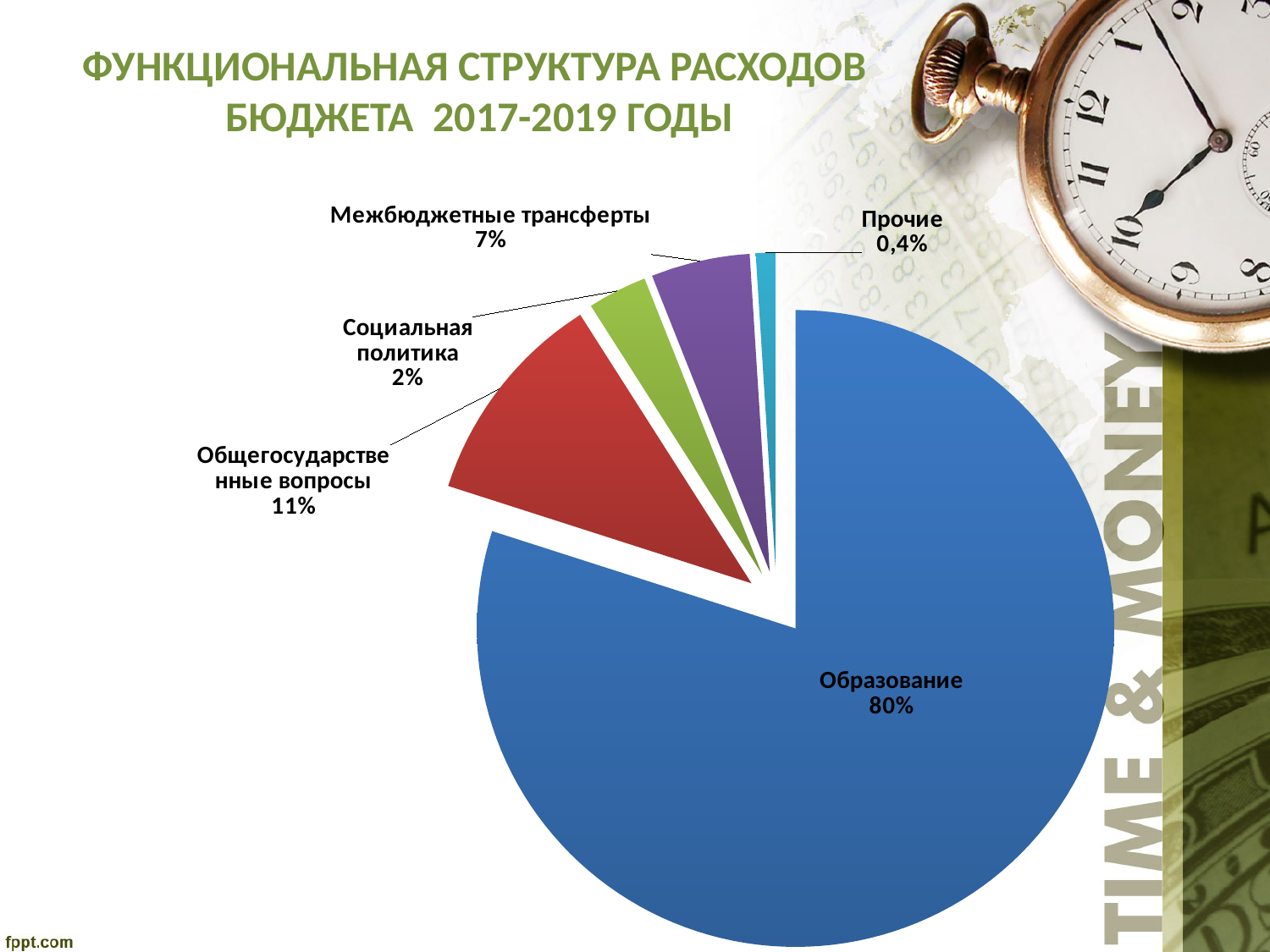
What share of the pie does Общегосударственные вопросы have? 11% How many slices does the pie chart have? 5 What is the difference in percentage points between Образование and Общегосударственные вопросы? 69 What share of the pie does Межбюджетные трансферты have? 7% What colour is the Образование slice? blue What share of the pie does Социальная политика have? 2% Which category has the largest slice of the pie? Образование Which is larger, the share for Межбюджетные трансферты or the share for Социальная политика? Межбюджетные трансферты Which category has the smallest slice of the pie? Прочие What kind of chart is shown on the slide? pie chart